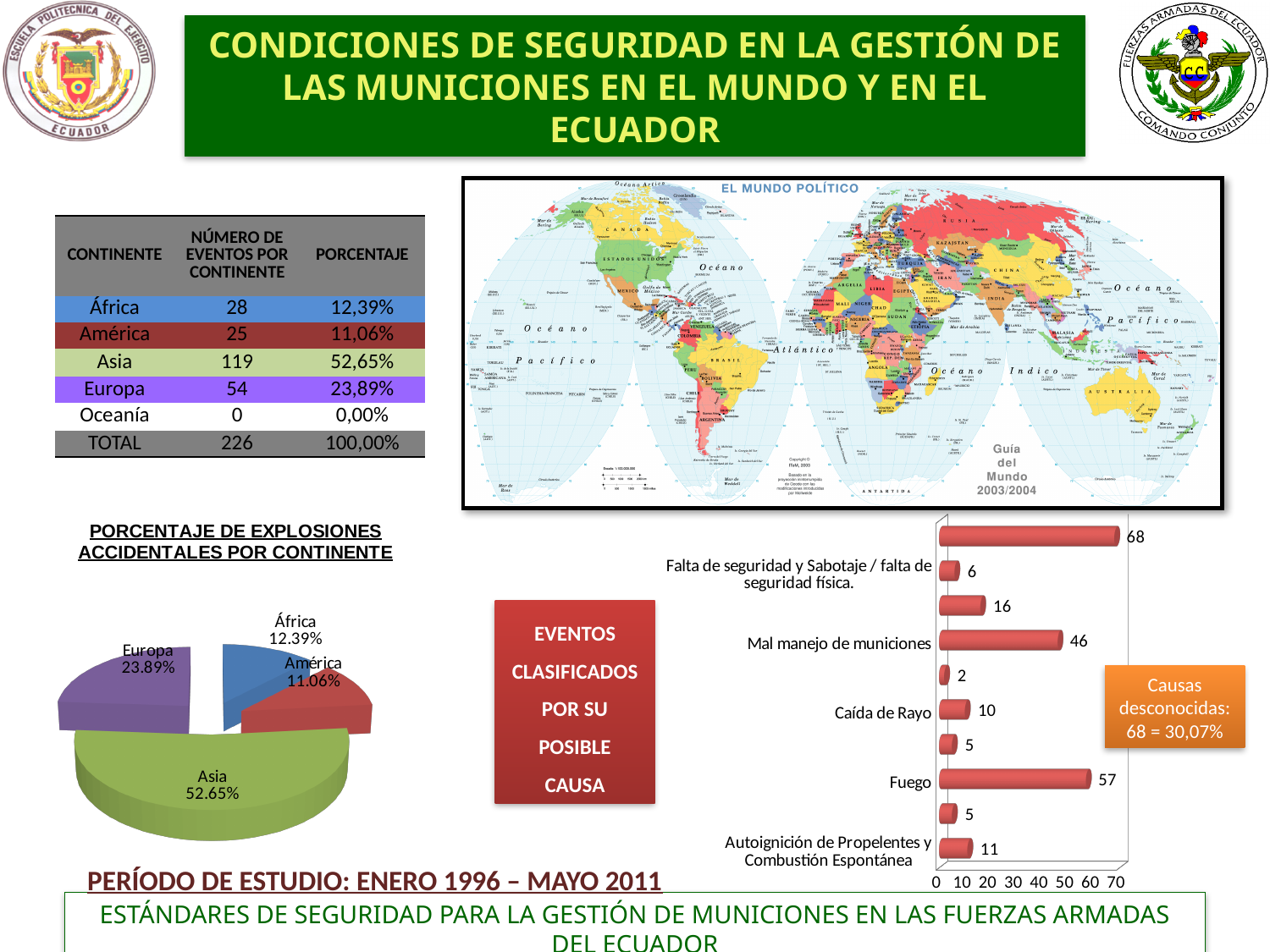
In the pie chart 'PORCENTAJE DE EXPLOSIONES ACCIDENTALES POR CONTINENTE', what percentage is shown for Asia? 52.65% What kind of chart is 'PORCENTAJE DE EXPLOSIONES ACCIDENTALES POR CONTINENTE'? Pie chart In the bar chart 'EVENTOS CLASIFICADOS POR SU POSIBLE CAUSA', what is the value for 'Caída de Rayo'? 10 In the pie chart 'PORCENTAJE DE EXPLOSIONES ACCIDENTALES POR CONTINENTE', what percentage is shown for Europa? 23.89% In the bar chart 'EVENTOS CLASIFICADOS POR SU POSIBLE CAUSA', what is the value for 'Fuego'? 57 In the bar chart 'EVENTOS CLASIFICADOS POR SU POSIBLE CAUSA', what is the largest value shown on any bar? 68 In the pie chart 'PORCENTAJE DE EXPLOSIONES ACCIDENTALES POR CONTINENTE', which labelled continent has the smallest slice? América In the bar chart 'EVENTOS CLASIFICADOS POR SU POSIBLE CAUSA', what is the value for 'Mal manejo de municiones'? 46 In the bar chart 'EVENTOS CLASIFICADOS POR SU POSIBLE CAUSA', what is the difference between the values for 'Fuego' and 'Mal manejo de municiones'? 11 In the pie chart 'PORCENTAJE DE EXPLOSIONES ACCIDENTALES POR CONTINENTE', which is larger, the slice for África or the slice for América? África What kind of chart is 'EVENTOS CLASIFICADOS POR SU POSIBLE CAUSA'? Bar chart In the pie chart 'PORCENTAJE DE EXPLOSIONES ACCIDENTALES POR CONTINENTE', which continent has the largest slice? Asia